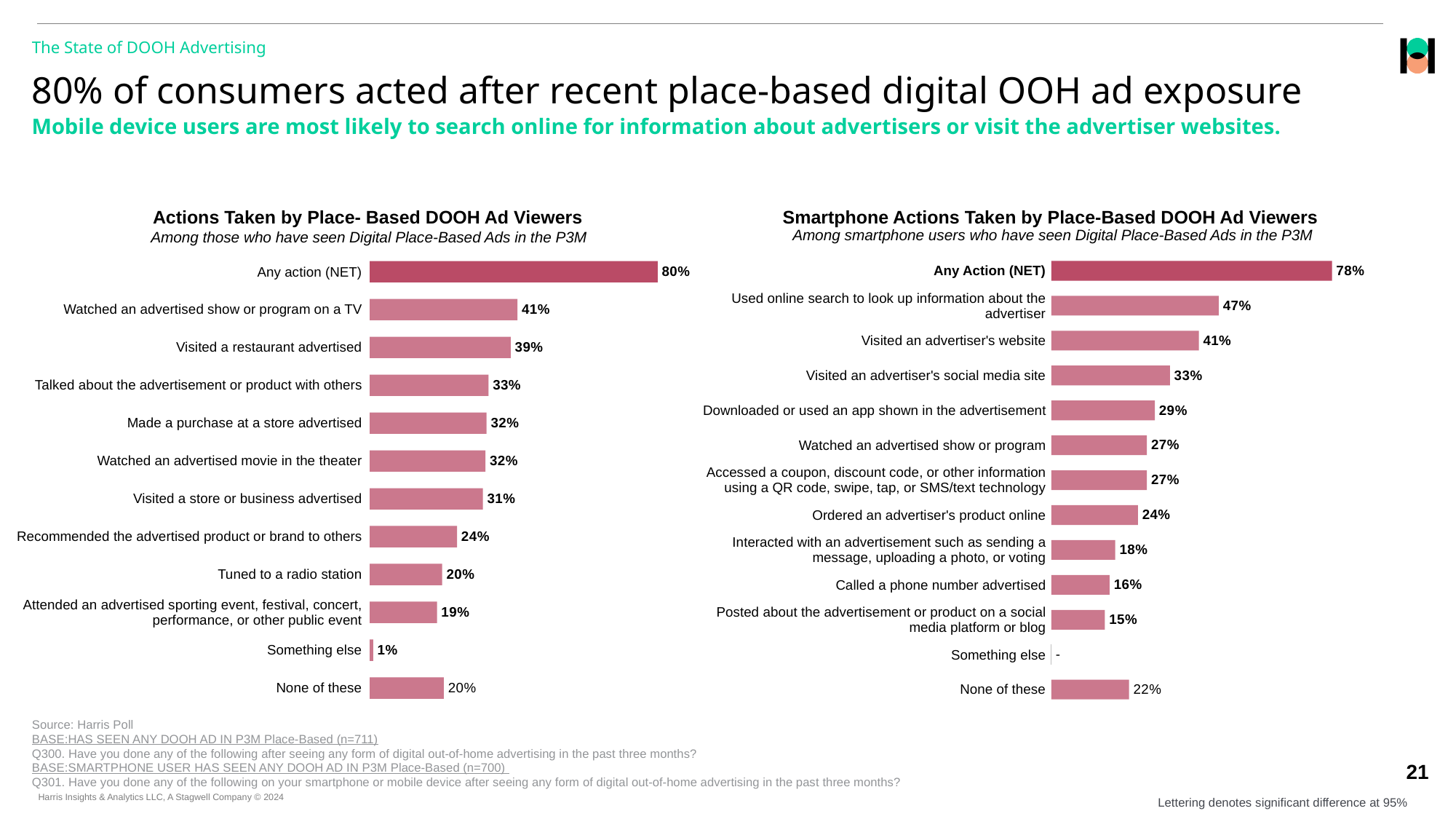
In the 'Smartphone Actions Taken by Place-Based DOOH Ad Viewers' chart, what is the value for 'Downloaded or used an app shown in the advertisement'? 29% In the 'Actions Taken by Place- Based DOOH Ad Viewers' chart, which category has the lowest value? Something else In the 'Smartphone Actions Taken by Place-Based DOOH Ad Viewers' chart, what is the difference between 'Used online search to look up information about the advertiser' and 'Visited an advertiser's website'? 6% In the 'Actions Taken by Place- Based DOOH Ad Viewers' chart, which is larger: 'Visited a store or business advertised' or 'Recommended the advertised product or brand to others'? Visited a store or business advertised What is the subtitle shown under the title of the 'Actions Taken by Place- Based DOOH Ad Viewers' chart? Among those who have seen Digital Place-Based Ads in the P3M In the 'Actions Taken by Place- Based DOOH Ad Viewers' chart, what is the value for 'Visited a restaurant advertised'? 39% How many categories are shown in the 'Actions Taken by Place- Based DOOH Ad Viewers' chart? 12 In the 'Smartphone Actions Taken by Place-Based DOOH Ad Viewers' chart, what is the value for 'None of these'? 22% In the 'Actions Taken by Place- Based DOOH Ad Viewers' chart, what is the difference between 'Watched an advertised show or program on a TV' and 'Tuned to a radio station'? 21% In the 'Smartphone Actions Taken by Place-Based DOOH Ad Viewers' chart, which is larger: 'Called a phone number advertised' or 'Ordered an advertiser's product online'? Ordered an advertiser's product online What kind of chart is the 'Smartphone Actions Taken by Place-Based DOOH Ad Viewers' chart? Bar chart In the 'Smartphone Actions Taken by Place-Based DOOH Ad Viewers' chart, which category has the highest value? Any Action (NET)